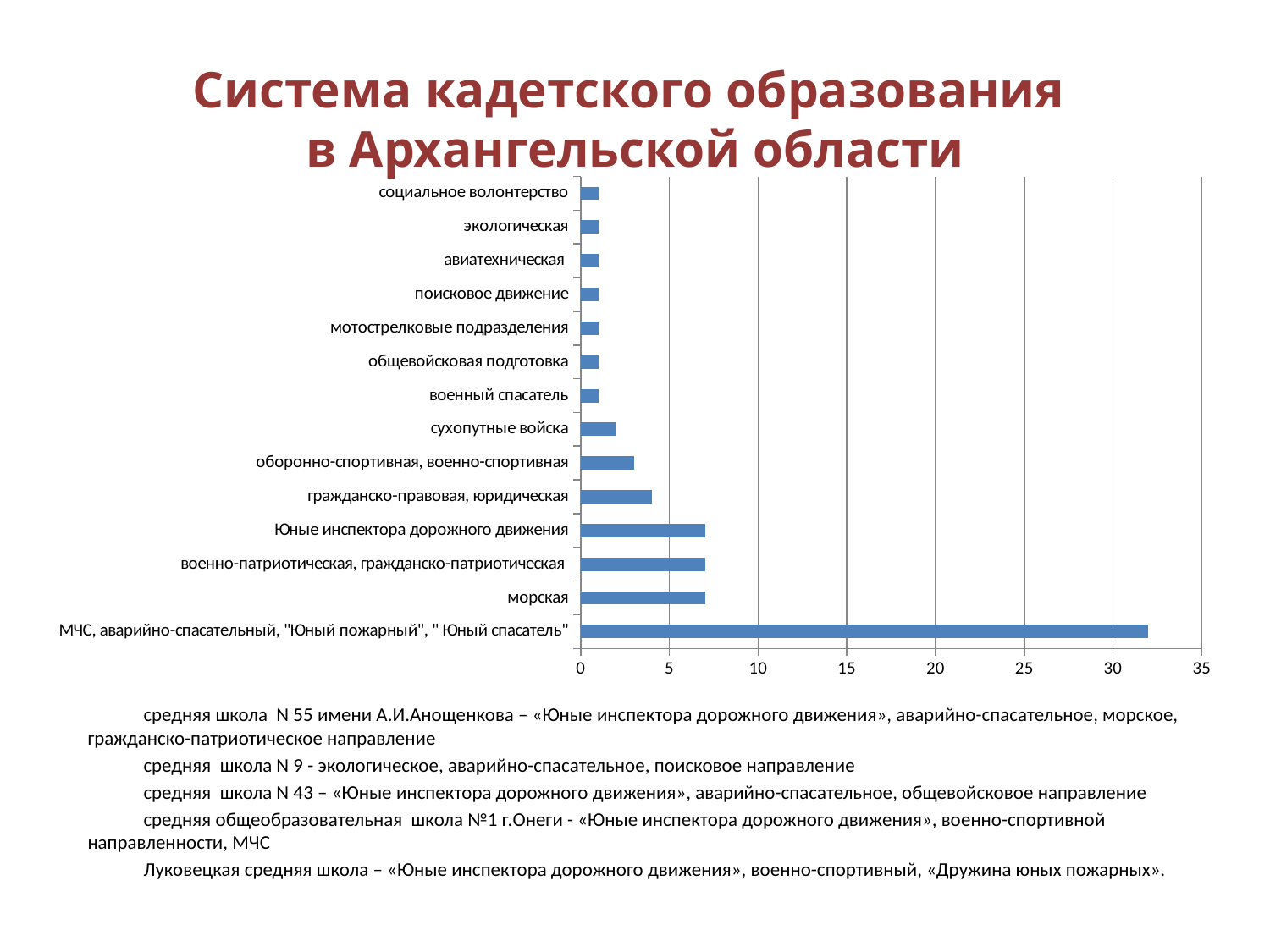
Is the value for Юные инспектора дорожного движения greater or less than 5? greater Is the value for МЧС, аварийно-спасательный, "Юный пожарный", " Юный спасатель" greater or less than 30? greater Which is larger, the value for МЧС, аварийно-спасательный, "Юный пожарный", " Юный спасатель" or the value for морская? МЧС, аварийно-спасательный, "Юный пожарный", " Юный спасатель" Which is larger, the value for гражданско-правовая, юридическая or the value for сухопутные войска? гражданско-правовая, юридическая How many categories are plotted in the chart? 14 Is the value for гражданско-правовая, юридическая greater or less than 5? less Which category has the highest value in the chart? МЧС, аварийно-спасательный, "Юный пожарный", " Юный спасатель" What is the title of the slide containing the chart? Система кадетского образования в Архангельской области What is the highest value shown on the horizontal axis of the chart? 35 What kind of chart is shown on the slide? bar chart